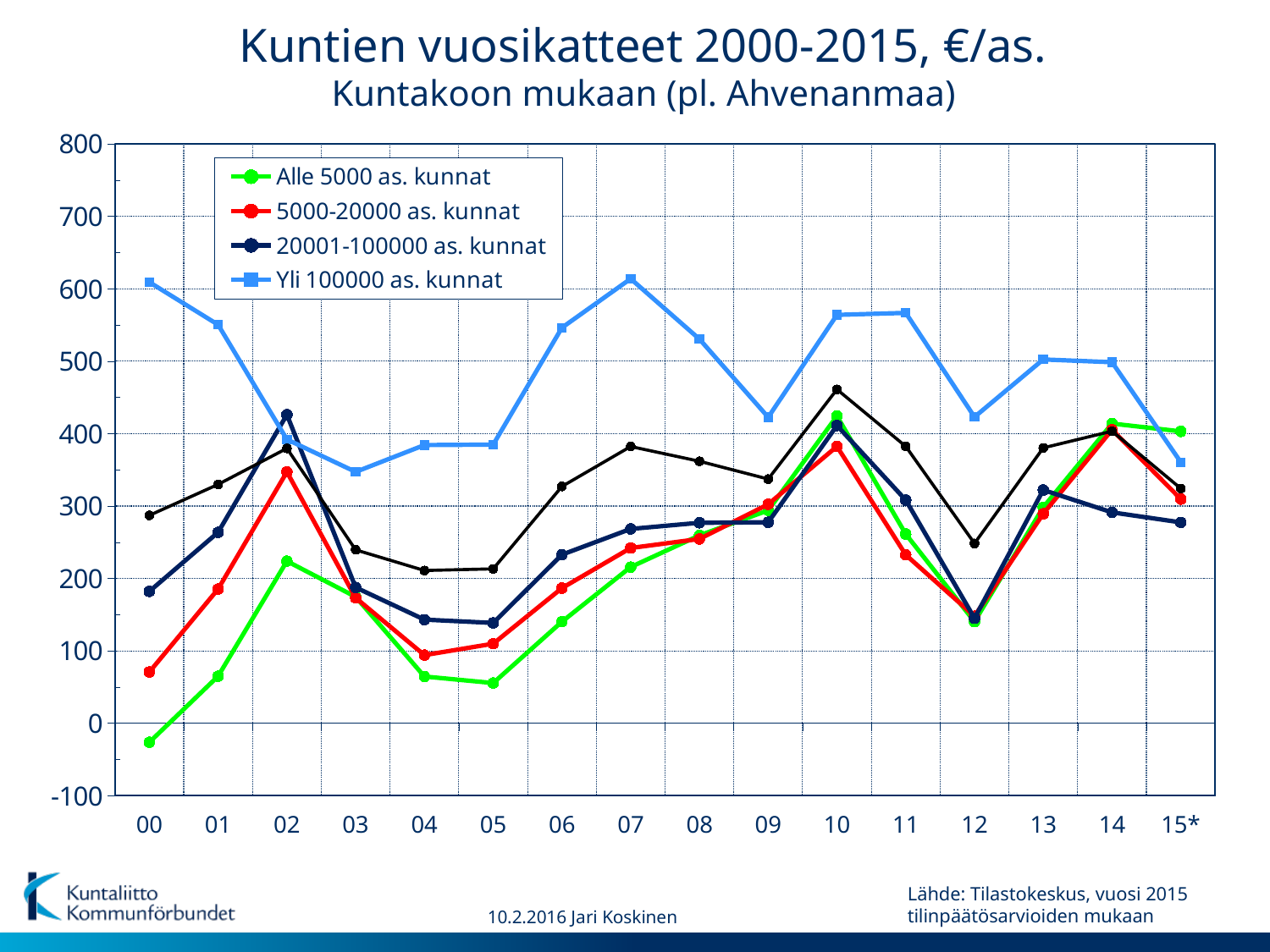
In which year is the value for 20001-100000 as. kunnat highest? 02 How many years are shown along the x axis? 16 Is the value for Yli 100000 as. kunnat in 07 greater or less than 600? greater Is the value for 5000-20000 as. kunnat in 04 greater or less than 200? less What colour is the line for Alle 5000 as. kunnat? green Is the value for 20001-100000 as. kunnat in 12 greater or less than 200? less What kind of chart is shown on the slide? line chart In 02, which series has the higher value: 20001-100000 as. kunnat or Yli 100000 as. kunnat? 20001-100000 as. kunnat Does the value for Yli 100000 as. kunnat rise or fall from 00 to 03? fall How many series does the legend list? 4 In which year is the value for Alle 5000 as. kunnat lowest? 00